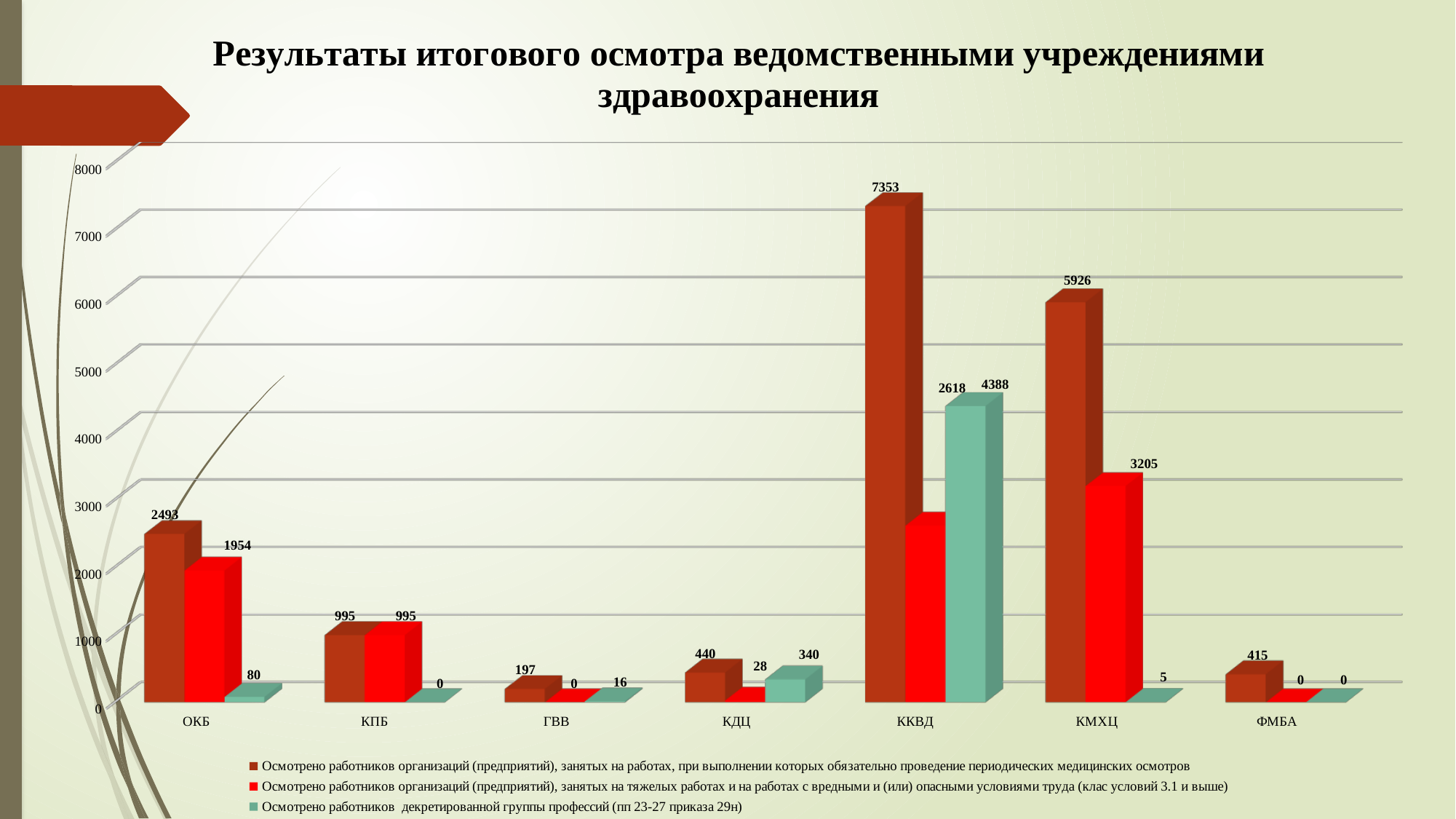
Which institution has the lowest value in the dark red (first) series? ГВВ What type of chart is shown on the slide? bar chart What is the value of the bright red (second) series for ККВД? 2618 What is the difference between the dark red series values for ККВД and КМХЦ? 1427 Which is larger for ОКБ: the dark red (first) series or the bright red (second) series? dark red (first) series How many series does the legend list? 3 What is the value of the teal (third) series for ОКБ? 80 Which institution has the highest value in the dark red (first) series? ККВД What is the value of the bright red (second) series for КМХЦ? 3205 What is the value of the dark red (first) series for ККВД? 7353 How many categories (institutions) are shown on the x axis? 7 What is the value of the teal (third) series for КДЦ? 340